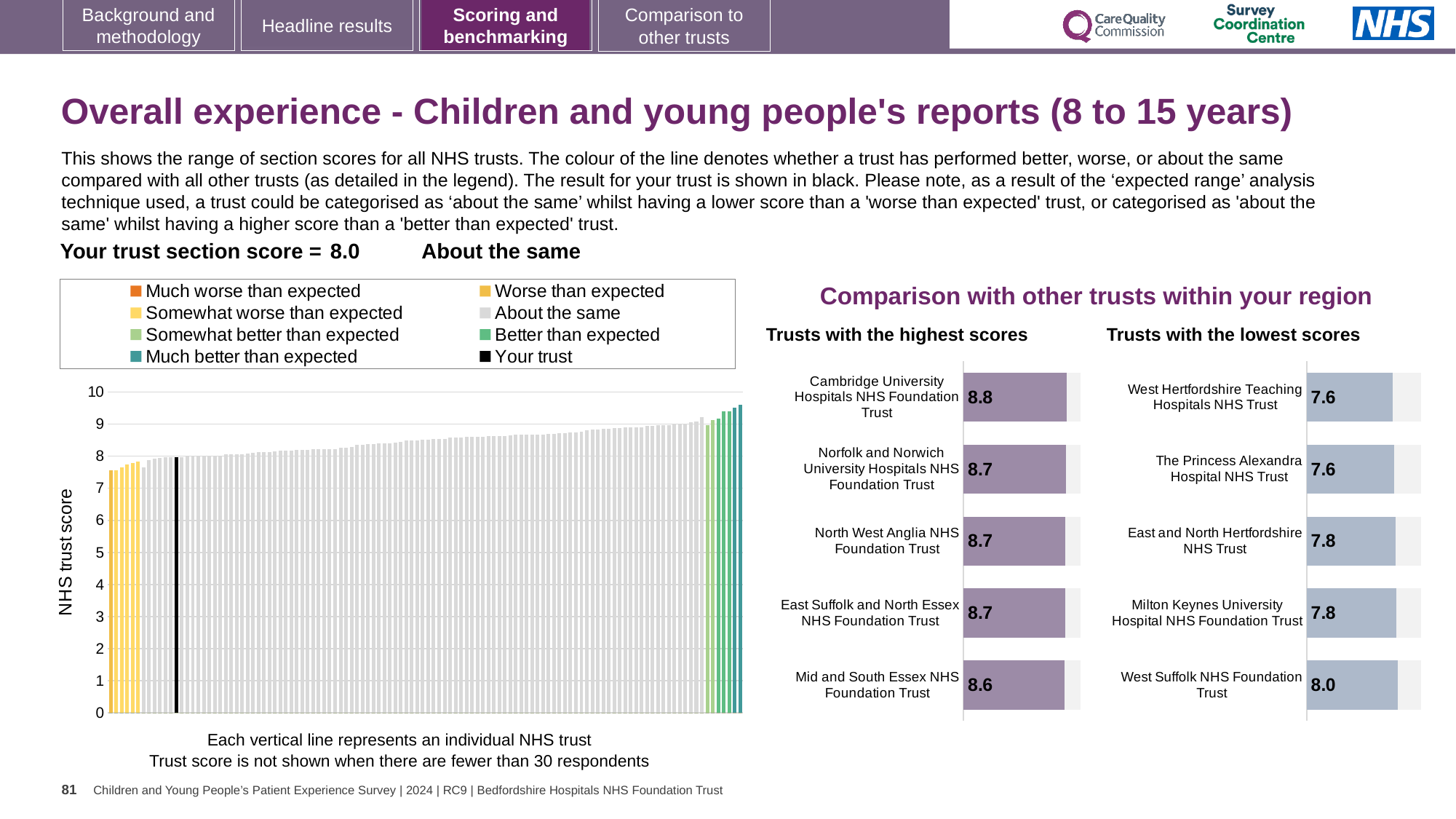
In the 'Trusts with the lowest scores' chart, what is the score for East and North Hertfordshire NHS Trust? 7.8 In the large chart on the left, is the value for the black 'Your trust' bar greater or less than 5? greater How many trusts are shown in the 'Trusts with the lowest scores' chart? 5 In the 'Trusts with the highest scores' chart, what is the score for Cambridge University Hospitals NHS Foundation Trust? 8.8 In the 'Trusts with the highest scores' chart, what is the difference between the scores of Cambridge University Hospitals NHS Foundation Trust and Mid and South Essex NHS Foundation Trust? 0.2 In the 'Trusts with the lowest scores' chart, which trust has the highest score? West Suffolk NHS Foundation Trust In the 'Trusts with the highest scores' chart, which trust has the lowest score? Mid and South Essex NHS Foundation Trust How many entries does the legend of the large chart on the left list? 8 What kind of chart is the large chart on the left with the y-axis labelled 'NHS trust score'? bar chart What is the section score for your trust shown on the slide? 8.0 In the large chart on the left, do the trust scores rise or fall from left to right? rise In the 'Trusts with the lowest scores' chart, what is the difference between the scores of West Suffolk NHS Foundation Trust and West Hertfordshire Teaching Hospitals NHS Trust? 0.4